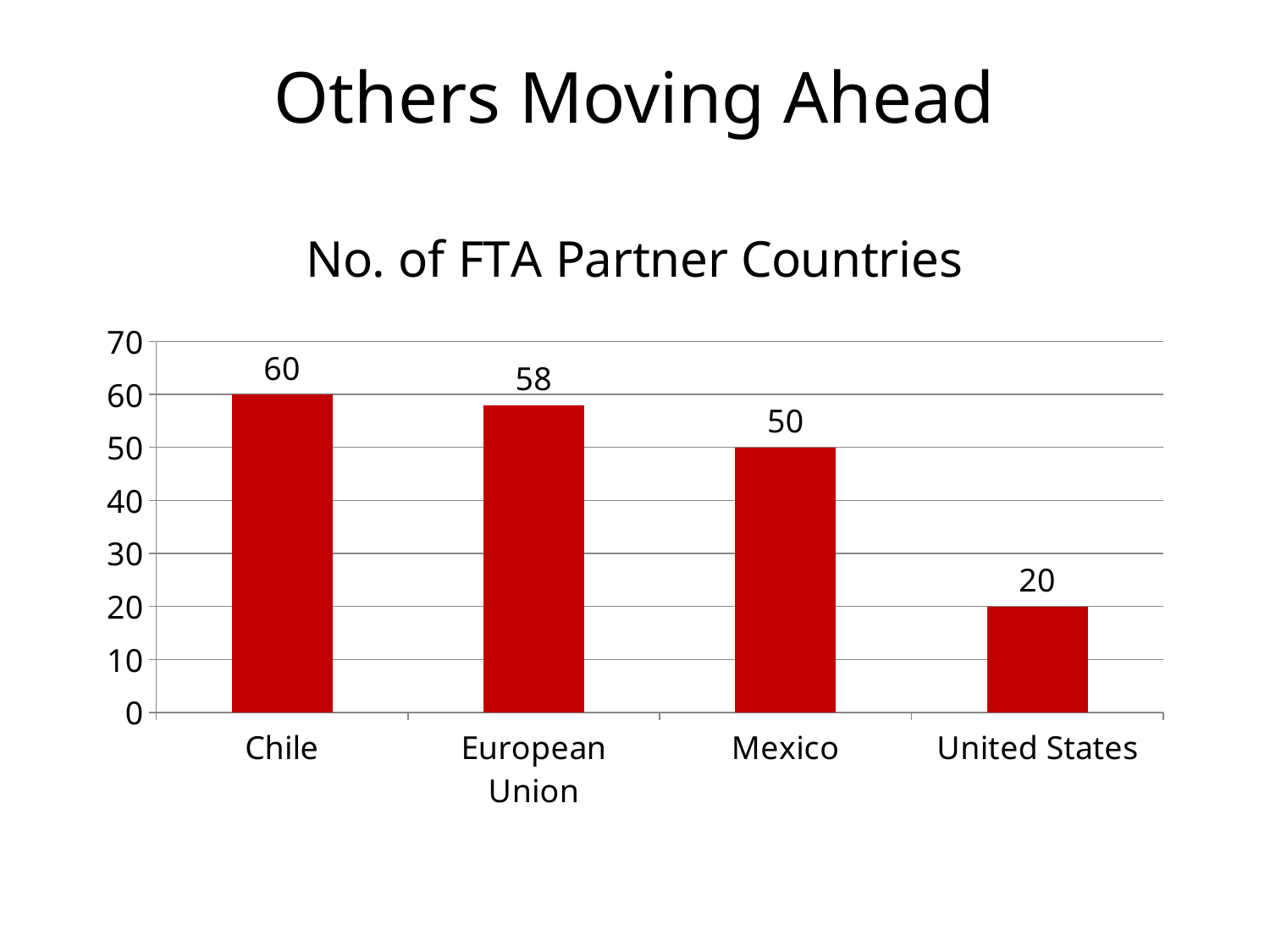
What is the difference between the number of FTA partner countries for Chile and the United States? 40 What is the number of FTA partner countries for the European Union? 58 What is the difference between the number of FTA partner countries for the European Union and Mexico? 8 Which category has the lowest number of FTA partner countries? United States What is the title of the chart? No. of FTA Partner Countries What is the number of FTA partner countries for the United States? 20 Which category has the highest number of FTA partner countries? Chile What is the number of FTA partner countries for Chile? 60 What is the number of FTA partner countries for Mexico? 50 Which has more FTA partner countries, Mexico or the United States? Mexico How many categories are shown in the chart? 4 What kind of chart is shown on the slide? Bar chart